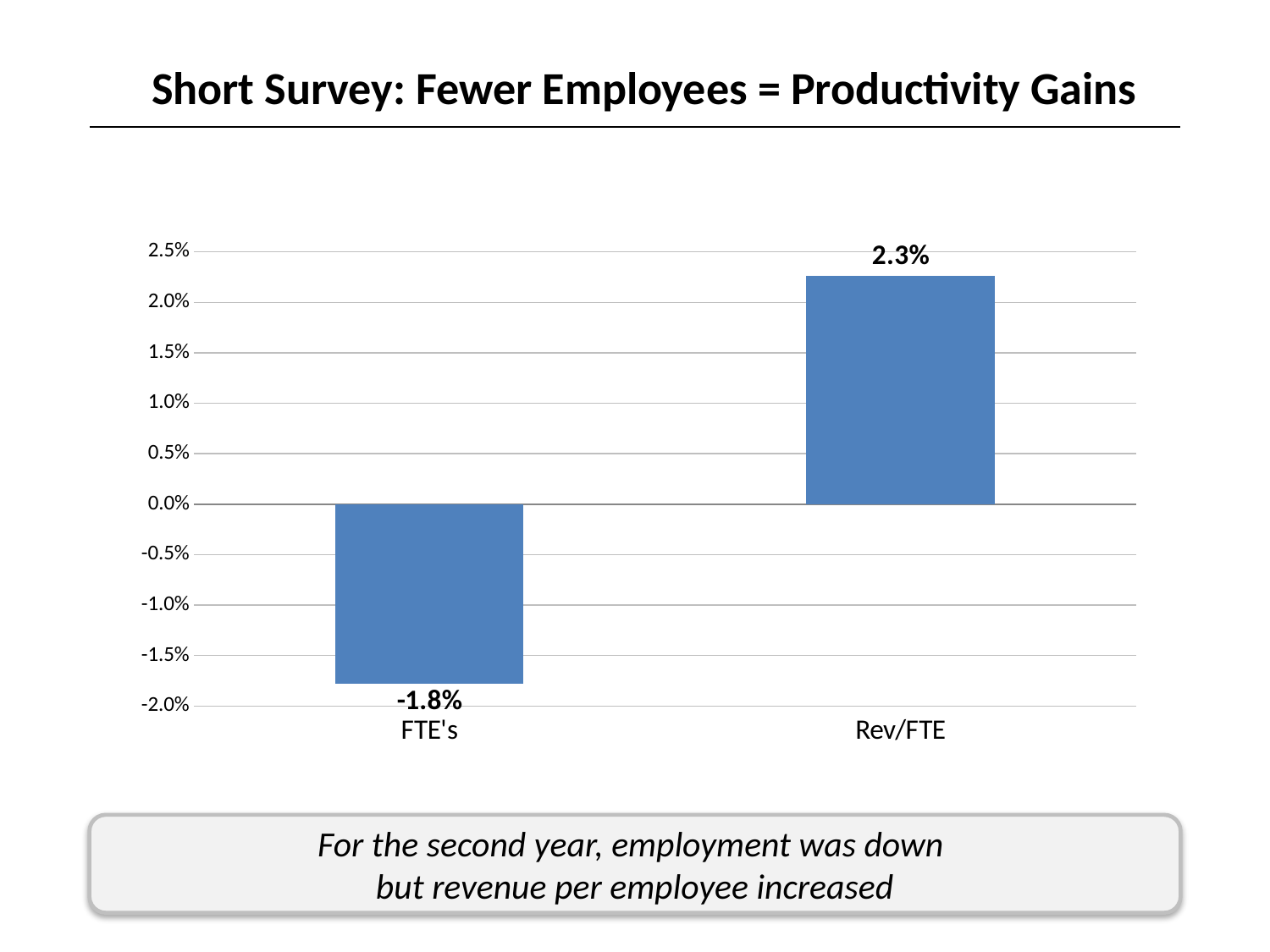
What is the value for FTE's? -1.8% What kind of chart is shown on the slide? bar chart Which category has the highest value? Rev/FTE Is the value for Rev/FTE greater or less than 2.0%? greater Is the value for FTE's greater or less than 0.0%? less Which is larger, the value for FTE's or the value for Rev/FTE? Rev/FTE What is the highest value shown on the vertical axis? 2.5% What is the title of the slide containing the chart? Short Survey: Fewer Employees = Productivity Gains What is the difference between the Rev/FTE value and the FTE's value? 4.1% What is the value for Rev/FTE? 2.3% How many categories are shown on the chart? 2 Which category has the lowest value? FTE's